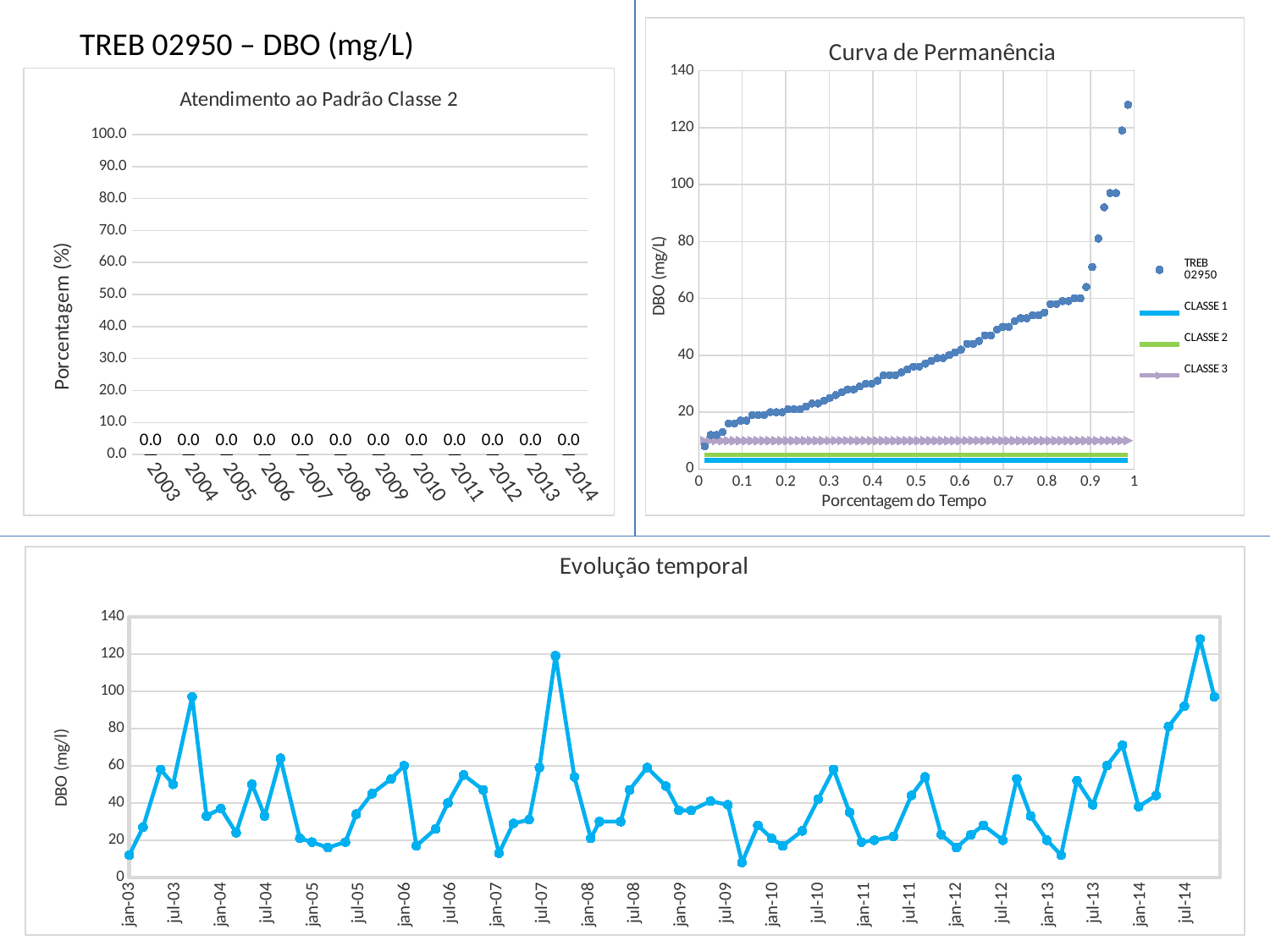
In the 'Atendimento ao Padrão Classe 2' chart, what is the value for 2010? 0.0 In the 'Curva de Permanência' chart, how many series does the legend list? 4 In the 'Atendimento ao Padrão Classe 2' chart, how many years are shown on the x axis? 12 In the 'Curva de Permanência' chart, is the highest TREB 02950 value greater or less than 120? greater In the 'Evolução temporal' chart, is the peak value near jul-07 greater or less than 100? greater What kind of chart is 'Evolução temporal'? line chart What is the x-axis label of the 'Curva de Permanência' chart? Porcentagem do Tempo What kind of chart is 'Atendimento ao Padrão Classe 2'? bar chart In the 'Curva de Permanência' chart, do the TREB 02950 values rise or fall as Porcentagem do Tempo increases? rise In the 'Curva de Permanência' chart, is the TREB 02950 value at 0.2 on the x axis greater or less than 40? less In the 'Evolução temporal' chart, which peak is higher, the one near jul-03 or the one near jul-14? jul-14 In the 'Atendimento ao Padrão Classe 2' chart, what is the value for 2014? 0.0